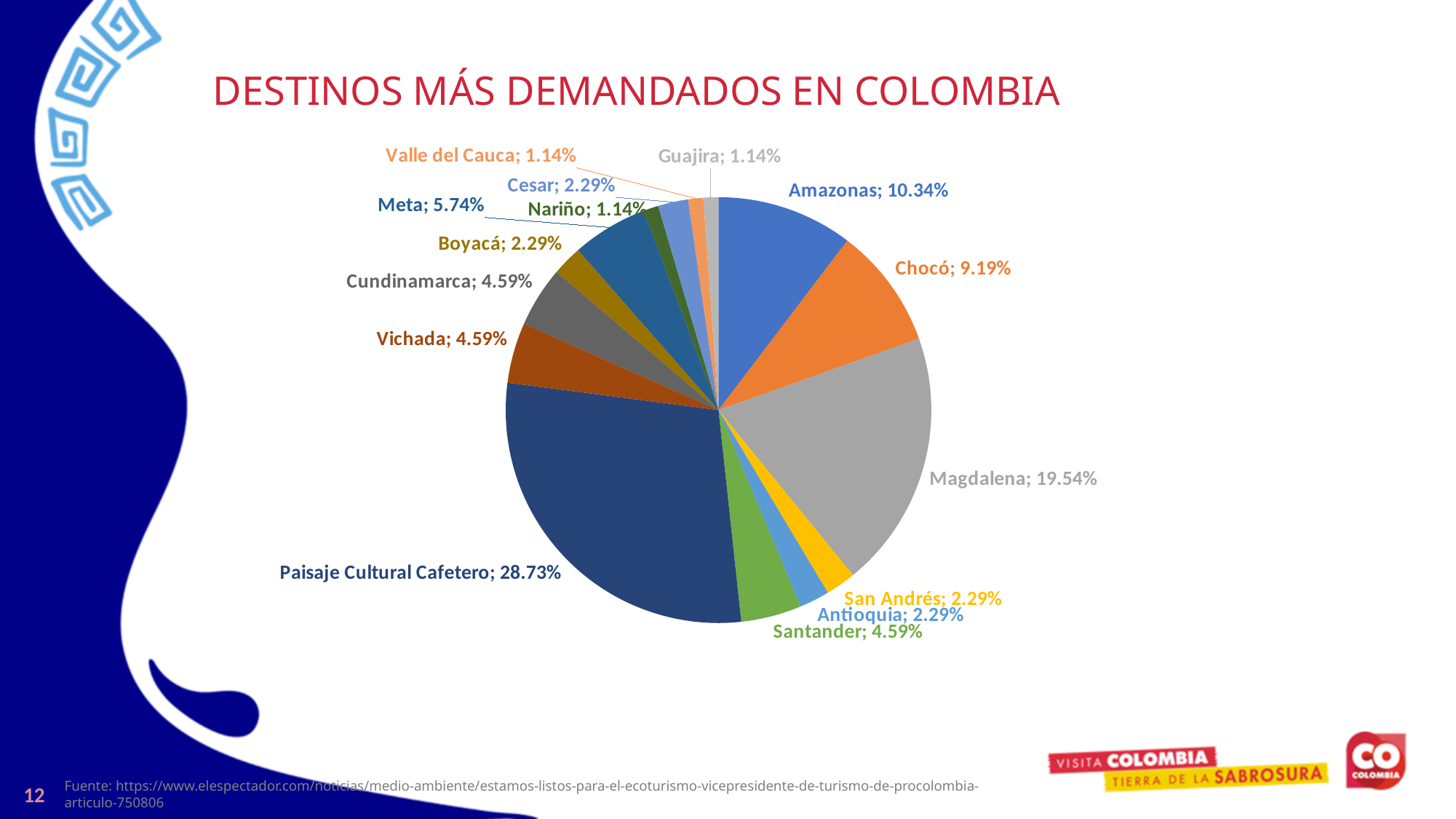
Which destination has the largest slice of the pie? Paisaje Cultural Cafetero How many destinations are shown in the pie chart? 15 What kind of chart is shown on the slide? pie chart What is the value shown for Magdalena? 19.54% What is the title of the chart on the slide? DESTINOS MÁS DEMANDADOS EN COLOMBIA What share of the pie does Paisaje Cultural Cafetero have? 28.73% What is the value shown for Amazonas? 10.34% What is the difference between the values for Magdalena and Chocó? 10.35% Which is larger, the slice for Chocó or the slice for Amazonas? Amazonas What is the value shown for Meta? 5.74% What is the value shown for Cundinamarca? 4.59% What is the difference between the values for Paisaje Cultural Cafetero and Magdalena? 9.19%